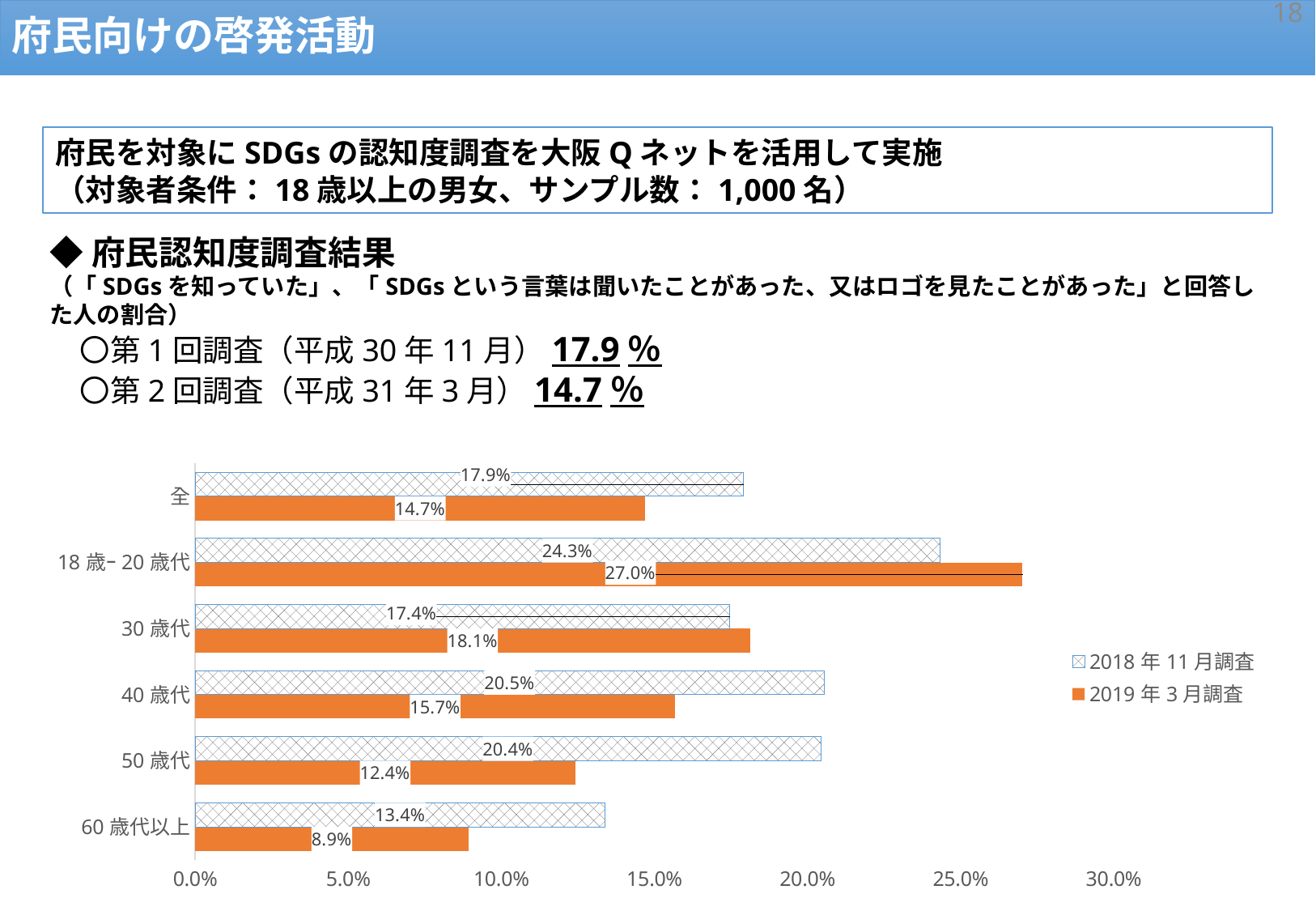
Which category has the highest value in the 2018年11月調査 series? 18歳-20歳代 What is the value for 60歳代以上 in the 2018年11月調査 series? 13.4% What is the value for 40歳代 in the 2019年3月調査 series? 15.7% How many series does the chart legend list? 2 For 30歳代, which survey has the larger value, 2018年11月調査 or 2019年3月調査? 2019年3月調査 How many age categories are plotted on the chart? 6 Is the 2018年11月調査 value for 40歳代 greater or less than 15.0%? greater Which category has the lowest value in the 2019年3月調査 series? 60歳代以上 What is the value for 18歳-20歳代 in the 2019年3月調査 series? 27.0% What kind of chart is shown on the slide? bar chart Which series is drawn with solid orange bars? 2019年3月調査 What is the difference between the 2018年11月調査 and 2019年3月調査 values for 50歳代? 8.0%